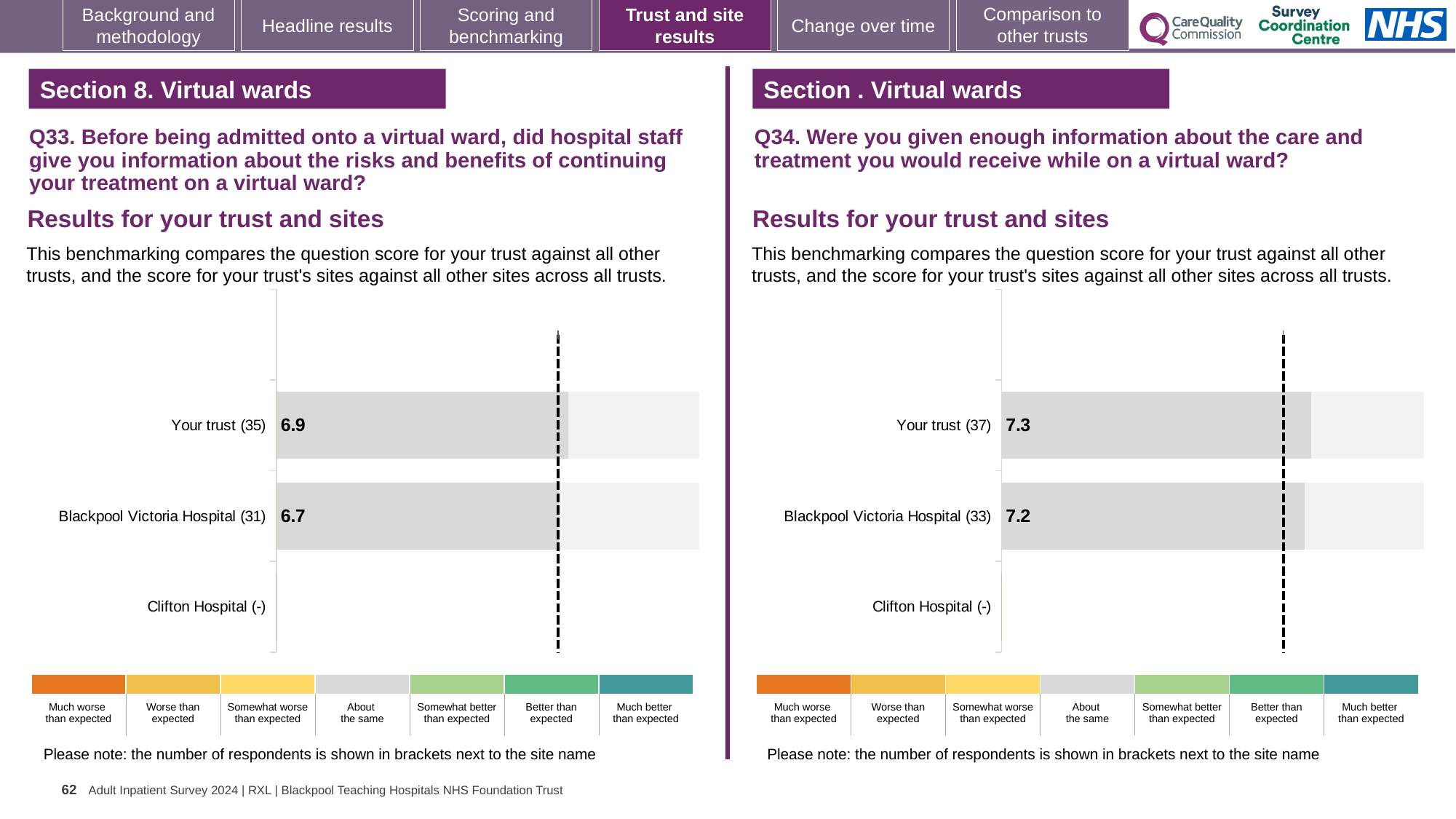
What kind of chart is the Q34 chart on the right? Bar chart In the Q33 chart on the left, what is the score for Your trust? 6.9 In the Q33 chart on the left, what is the difference between the score for Your trust and the score for Blackpool Victoria Hospital? 0.2 In the Q33 chart on the left, which has the higher score, Your trust or Blackpool Victoria Hospital? Your trust In the Q33 chart on the left, how many respondents are shown in brackets for Blackpool Victoria Hospital? 31 In the Q33 chart on the left, what is the score for Blackpool Victoria Hospital? 6.7 In the Q34 chart on the right, what is the score for Blackpool Victoria Hospital? 7.2 In the Q34 chart on the right, which has the higher score, Your trust or Blackpool Victoria Hospital? Your trust In the Q34 chart on the right, what is the score for Your trust? 7.3 In the Q34 chart on the right, how many respondents are shown in brackets for Your trust? 37 How many categories are listed on the vertical axis of the Q33 chart on the left? 3 In the Q34 chart on the right, what is the difference between the score for Your trust and the score for Blackpool Victoria Hospital? 0.1